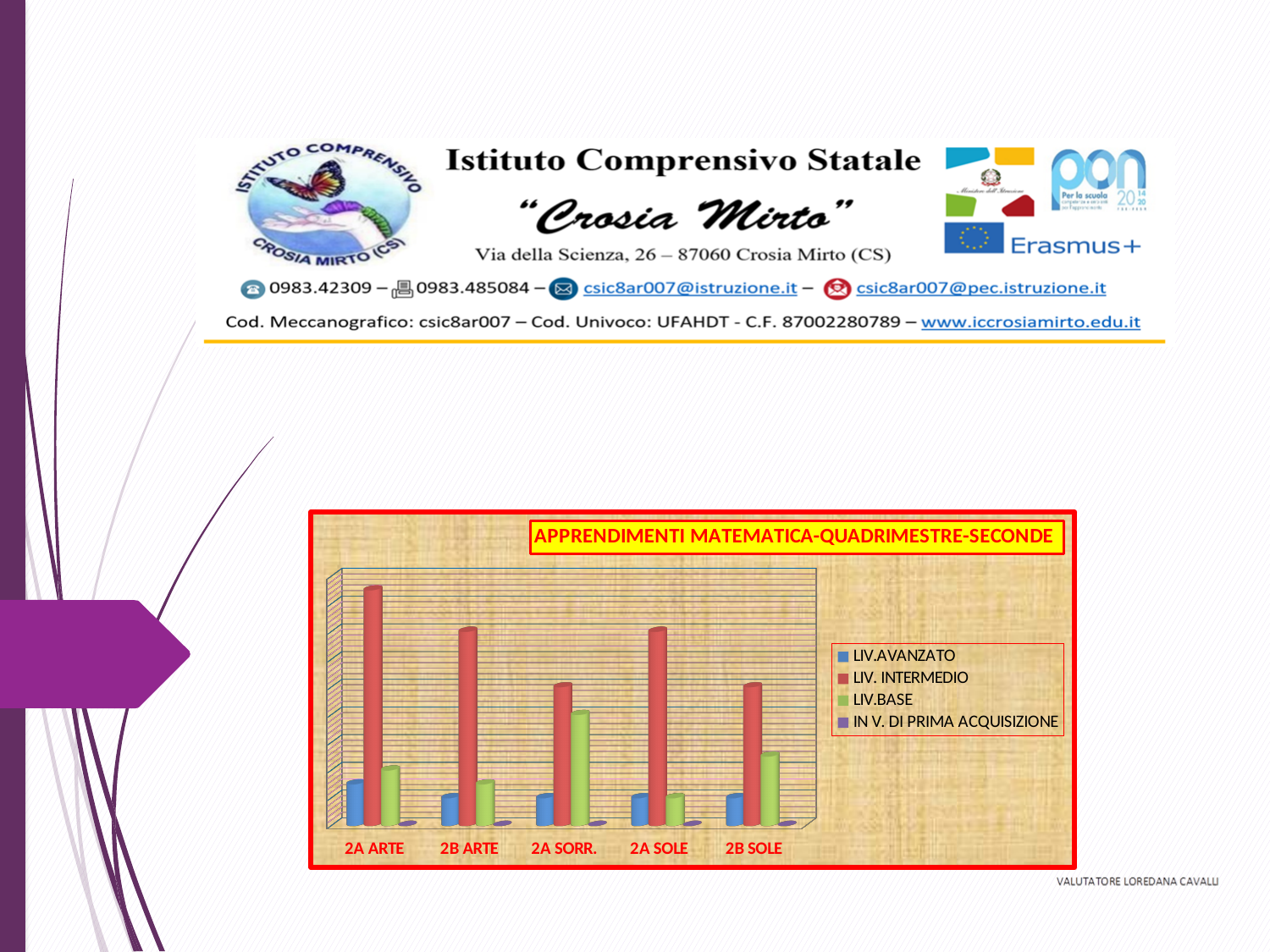
Which class has the larger LIV.AVANZATO bar: 2A ARTE or 2B ARTE? 2A ARTE Which series has the highest bar in every class? LIV. INTERMEDIO How many classes (categories) are shown on the x axis of the chart? 5 What kind of chart is shown on the slide? bar chart For 2A ARTE, which is larger: LIV. INTERMEDIO or LIV.BASE? LIV. INTERMEDIO Which colour represents LIV. INTERMEDIO in the chart? red Which series has the lowest bars in every class? IN V. DI PRIMA ACQUISIZIONE For which class is the LIV.BASE bar the highest? 2A SORR. Which class has the larger LIV.BASE bar: 2A SORR. or 2B SOLE? 2A SORR. For which class is the LIV. INTERMEDIO bar the highest? 2A ARTE What is the title of the chart? APPRENDIMENTI MATEMATICA-QUADRIMESTRE-SECONDE How many series does the chart legend list? 4